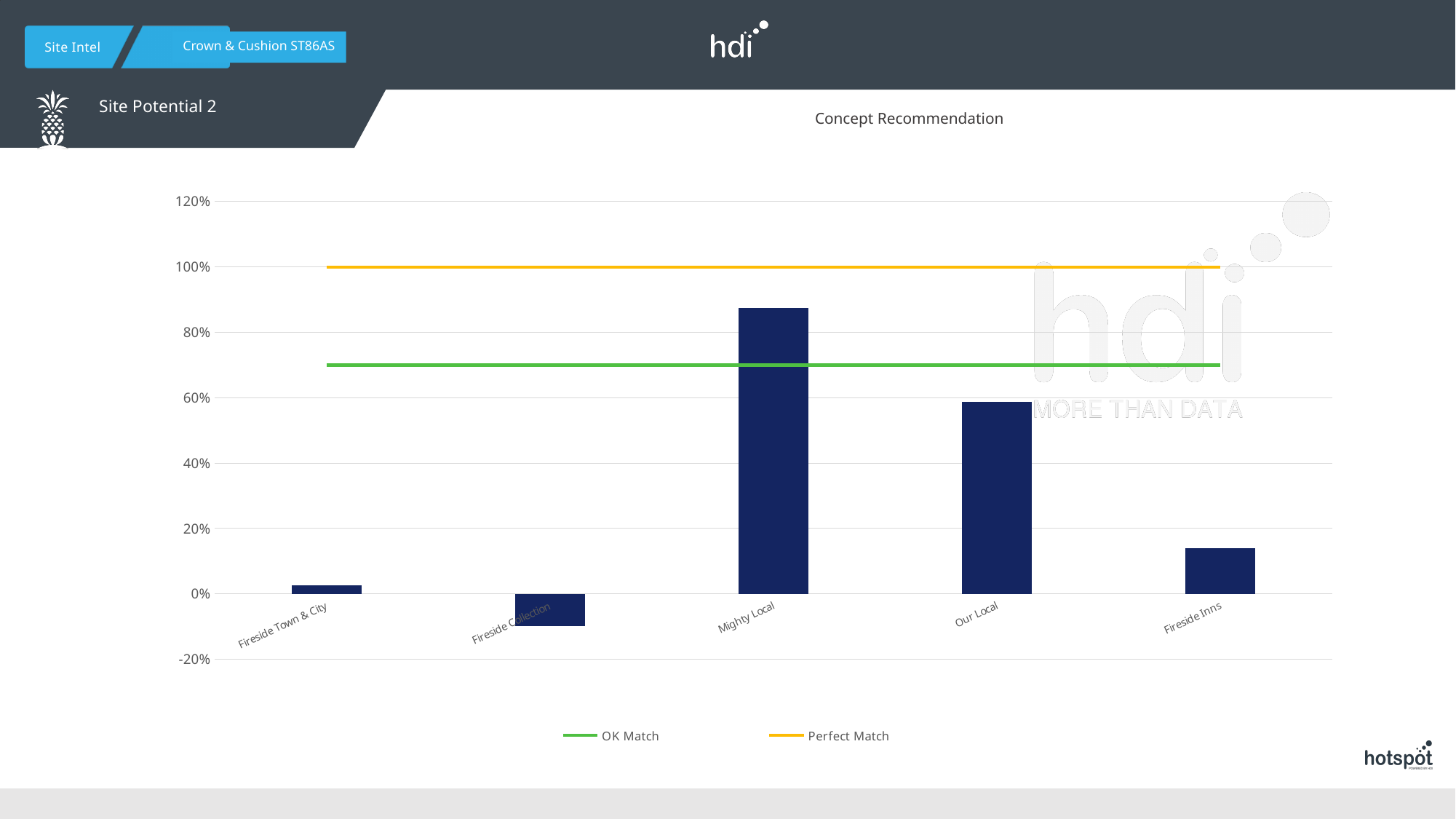
What is the title of the chart? Concept Recommendation Which is larger, the value for Our Local or the value for Fireside Inns? Our Local Which category has the highest bar in the chart? Mighty Local Is the value for Our Local greater or less than 60%? less At what level is the Perfect Match line drawn on the chart? 100% How many categories are shown on the x axis of the chart? 5 Is the value for Mighty Local greater or less than 80%? greater Is the value for Fireside Collection greater or less than 0%? less Which category has the lowest bar in the chart? Fireside Collection What kind of chart is shown on the slide? bar chart What colour is the OK Match line in the chart's legend? green How many series does the chart's legend list? 2